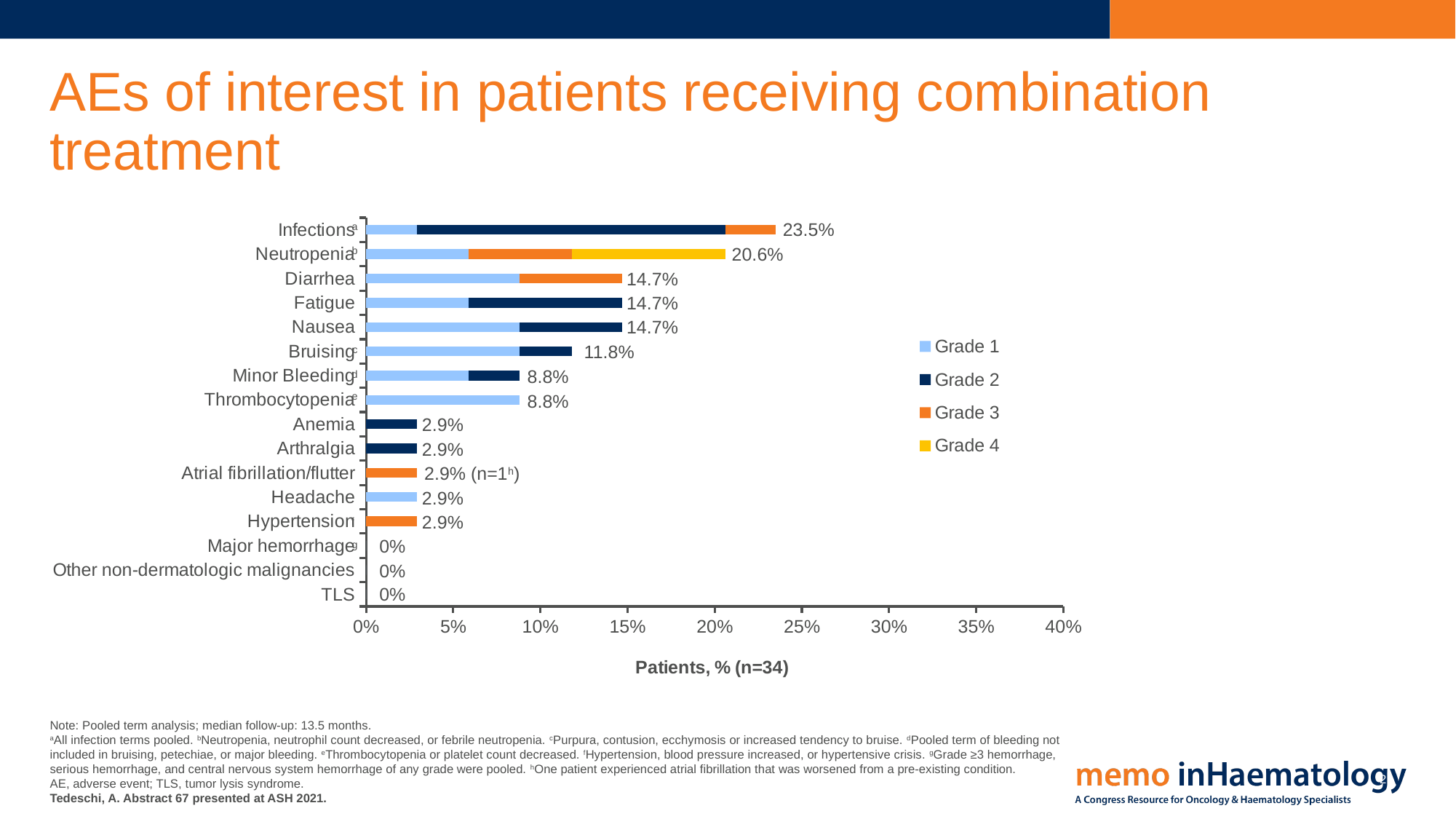
Is the total value for Infections greater or less than 20%? greater What is the total percentage of patients with Neutropenia? 20.6% What is the total percentage of patients with Bruising? 11.8% Which adverse events have a total of 0%? Major hemorrhage, Other non-dermatologic malignancies, TLS How many adverse event categories are listed on the y axis? 16 How many series does the legend list? 4 What kind of chart is shown on the slide? Stacked horizontal bar chart Which has a higher total percentage, Bruising or Minor Bleeding? Bruising Which adverse event is the only one with a Grade 4 segment? Neutropenia What is the total percentage of patients with Infections? 23.5% What is the difference in total percentage between Infections and Neutropenia? 2.9 percentage points Which adverse event has the highest total percentage of patients? Infections